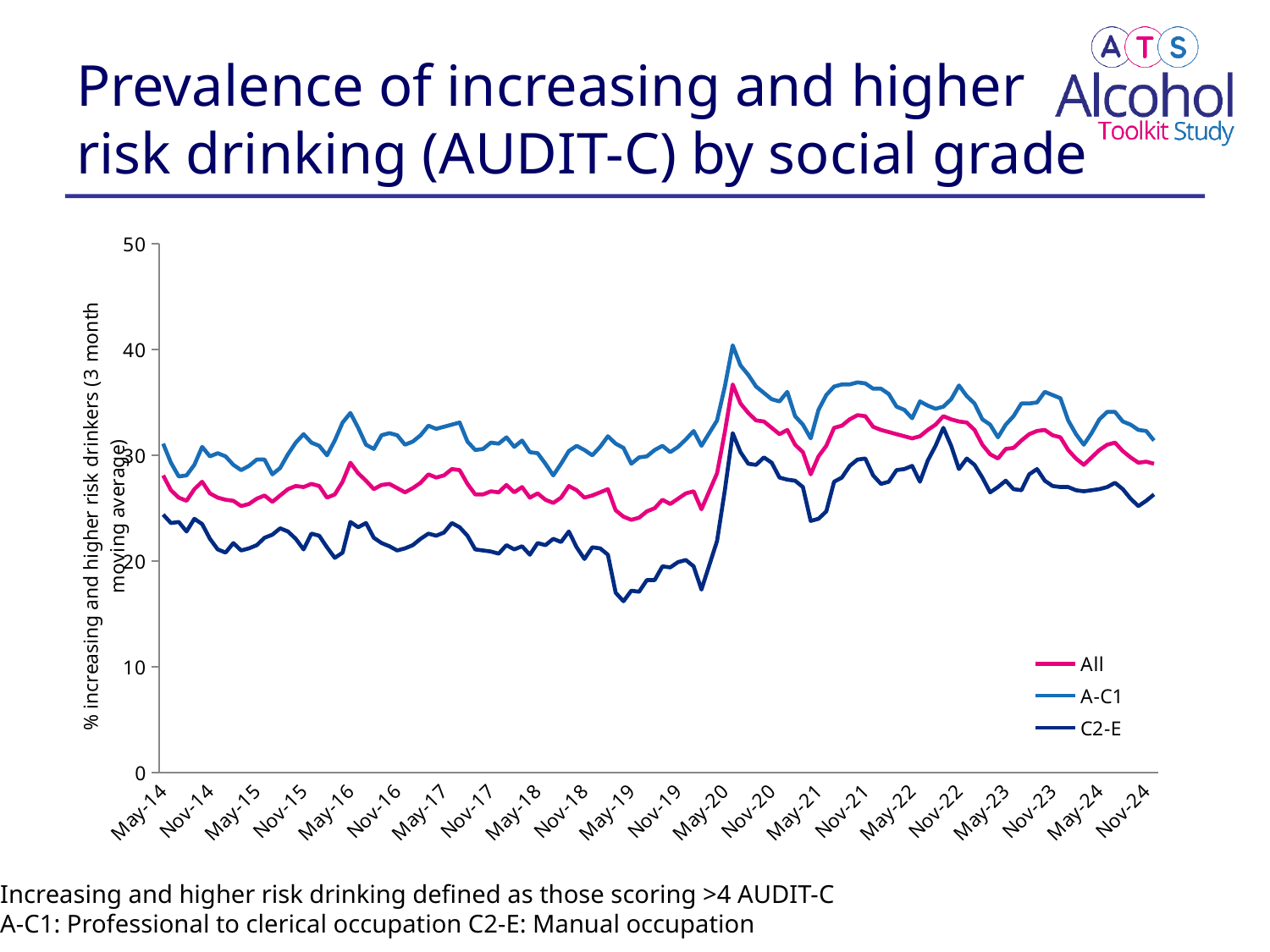
Which series has the lowest values across the whole period? C2-E Is the value for C2-E at Nov-24 greater or less than 30? less What kind of chart is shown on the slide? line chart What are the three series named in the legend? All, A-C1, C2-E Is the value for C2-E at May-14 greater or less than 20? greater What is the highest value shown on the y axis? 50 Which is larger at May-20: the value for A-C1 or the value for C2-E? A-C1 How many series does the legend list? 3 Is the value for C2-E at May-19 greater or less than 20? less Does the C2-E line rise or fall between Nov-19 and May-20? rise Which series has the highest values across the whole period? A-C1